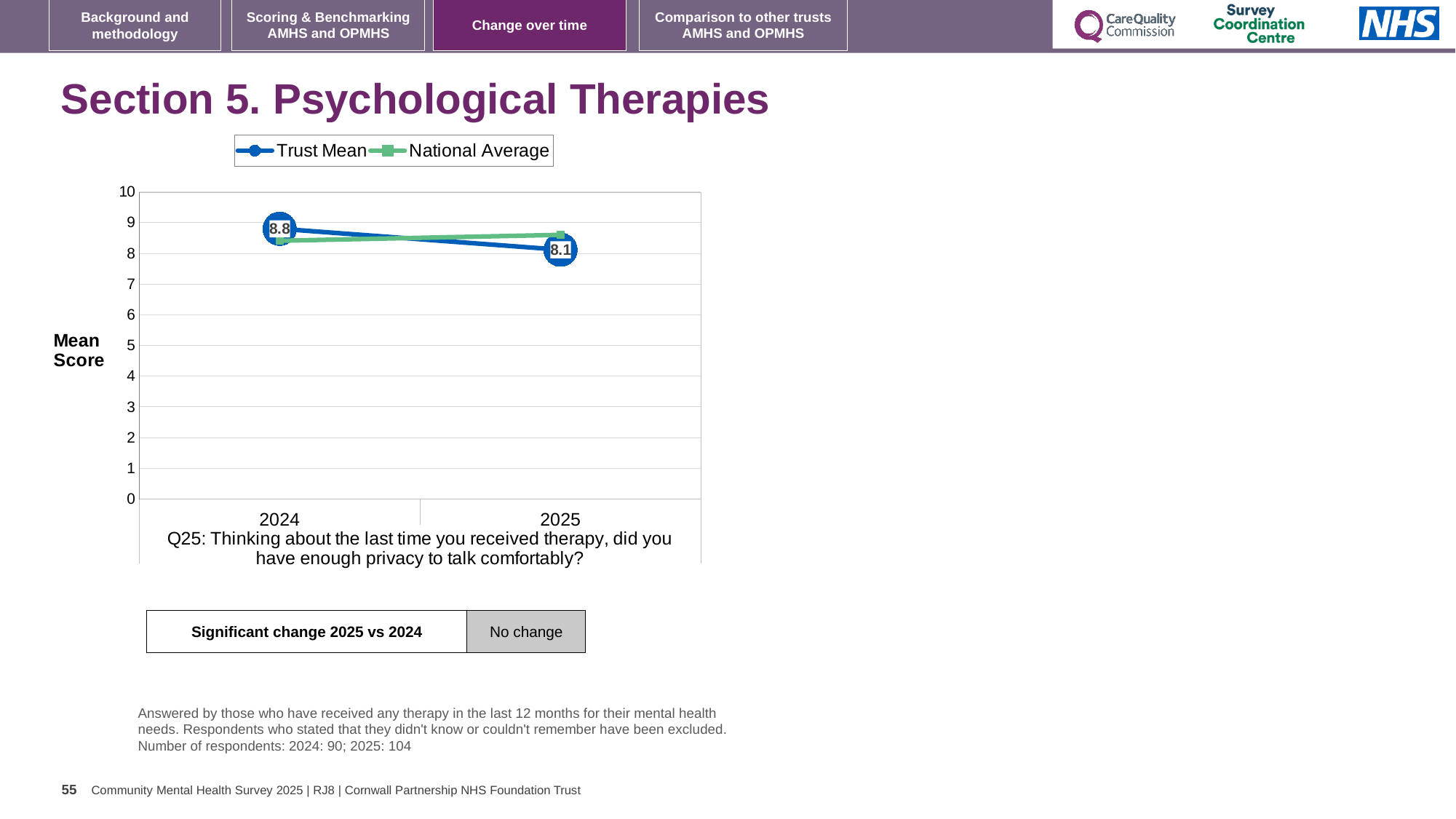
What is the Trust Mean score for 2025? 8.1 What type of chart is shown on the slide? line chart What is the Trust Mean score for 2024? 8.8 Which year has the higher Trust Mean score, 2024 or 2025? 2024 By how much did the Trust Mean score fall from 2024 to 2025? 0.7 Does the Trust Mean rise or fall from 2024 to 2025? fall How many years are plotted on the x axis of the chart? 2 What is the label on the y axis of the chart? Mean Score Is the National Average value for 2025 greater or less than 8? greater How many series does the chart legend list? 2 In 2025, which is higher: the Trust Mean or the National Average? National Average Is the National Average value for 2024 greater or less than 9? less